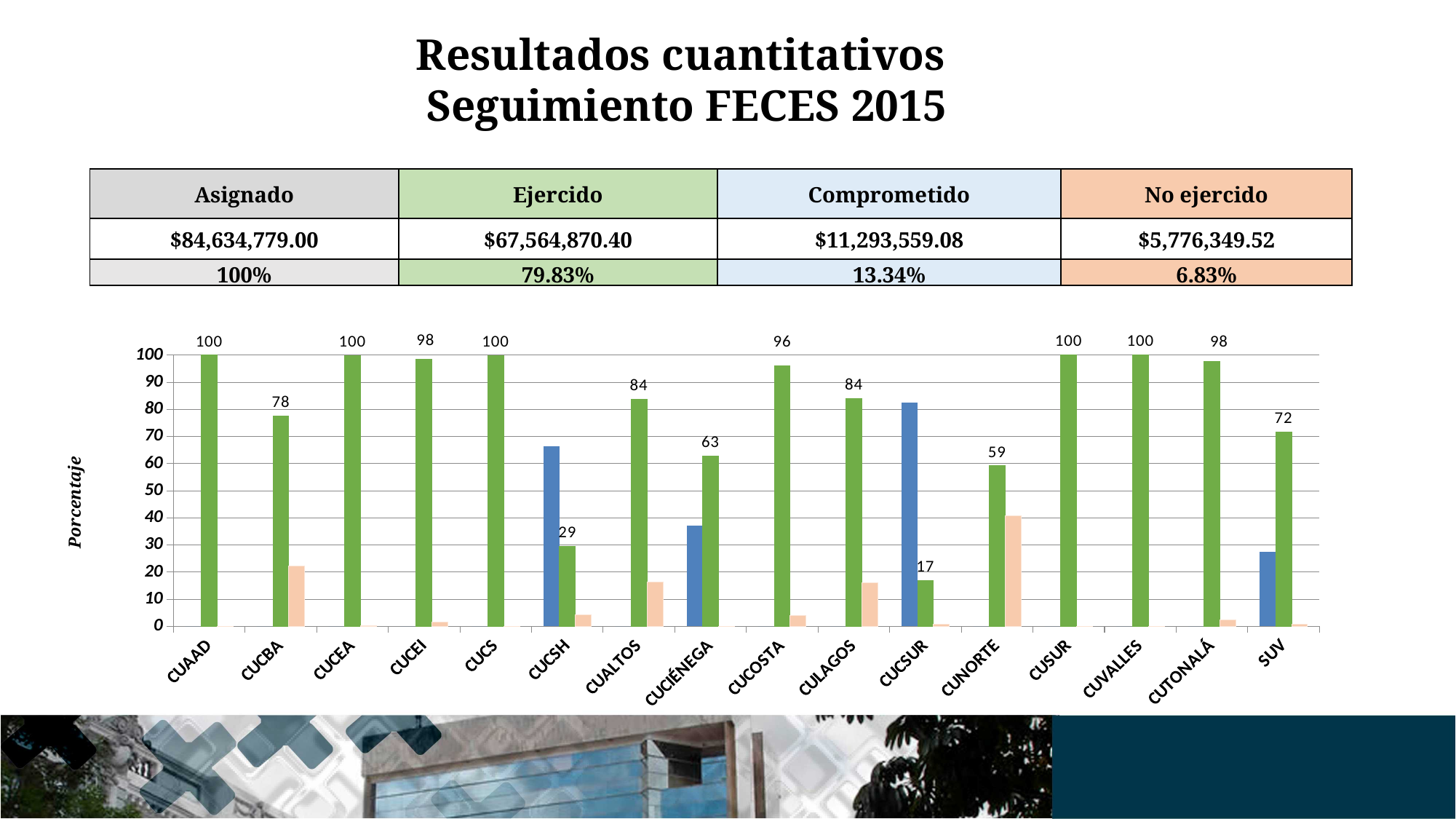
What is the difference between the green bar values for CUCOSTA and SUV? 24 What is the label of the vertical axis of the chart? Porcentaje Which category has the lowest green bar value? CUCSUR What is the value of the green bar for CUCIÉNEGA? 63 What is the value of the green bar for CUCBA? 78 Is the orange bar for CUNORTE greater or less than 30? greater Is the blue bar for SUV greater or less than 40? less How many categories are shown on the x axis of the chart? 16 Is the blue bar for CUCSUR greater or less than 70? greater What kind of chart is shown on the slide? Bar chart What is the value of the green bar for CUNORTE? 59 Which has a larger green bar value, CUALTOS or CUCSH? CUALTOS